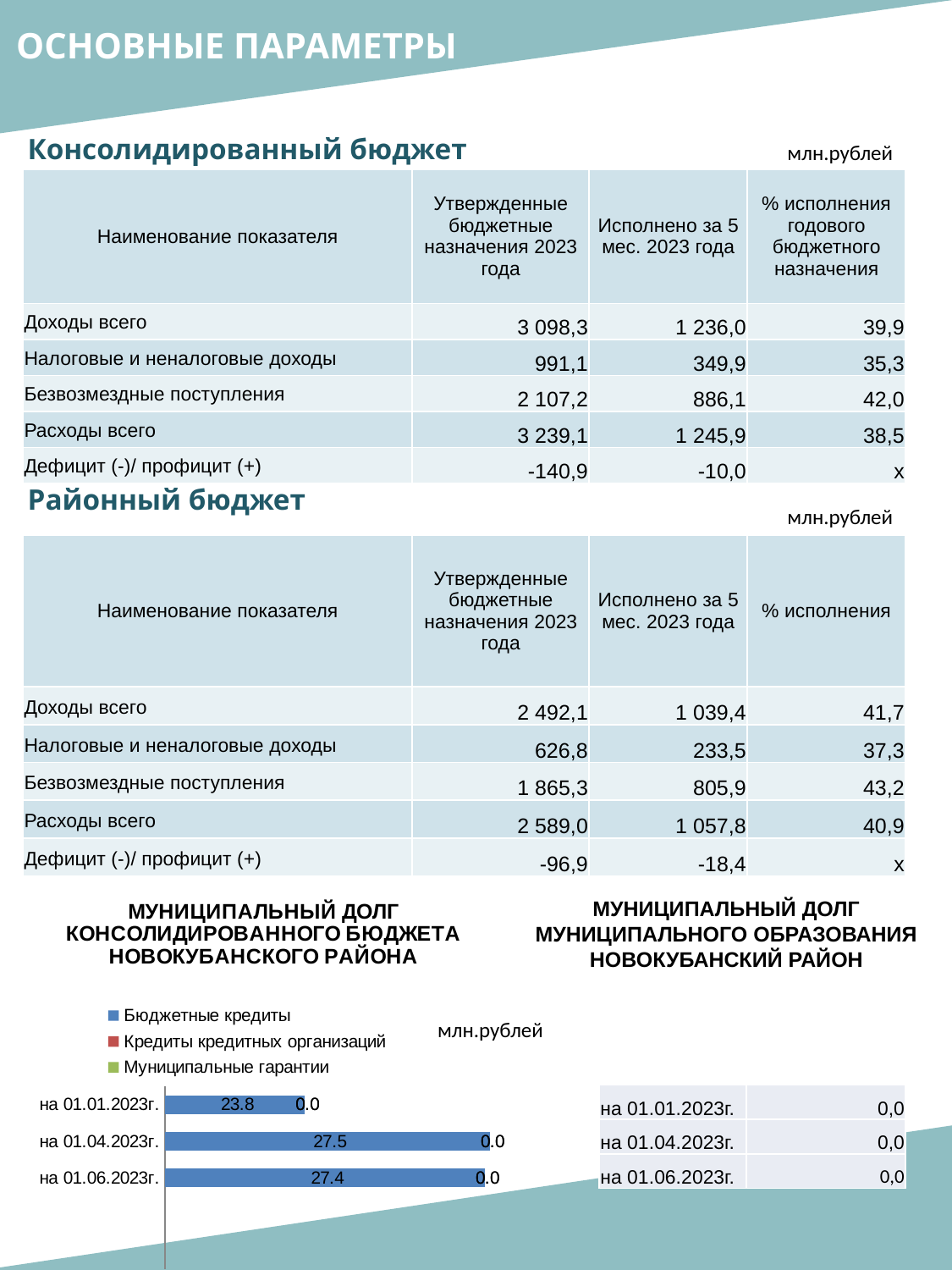
In the bar chart, what is the value of "Бюджетные кредиты" for "на 01.04.2023г."? 27.5 What kind of chart is shown under the title "МУНИЦИПАЛЬНЫЙ ДОЛГ КОНСОЛИДИРОВАННОГО БЮДЖЕТА НОВОКУБАНСКОГО РАЙОНА"? bar chart In the bar chart, what is the value of "Бюджетные кредиты" for "на 01.01.2023г."? 23.8 In the bar chart, which date has the lowest value for "Бюджетные кредиты"? на 01.01.2023г. In the bar chart, which is larger: the "Бюджетные кредиты" value for "на 01.01.2023г." or for "на 01.06.2023г."? на 01.06.2023г. In the bar chart, what is the value of "Бюджетные кредиты" for "на 01.06.2023г."? 27.4 What unit is indicated next to the bar chart? млн.рублей In the bar chart, what is the difference between the "Бюджетные кредиты" values for "на 01.04.2023г." and "на 01.01.2023г."? 3.7 How many date categories are shown in the bar chart? 3 How many series does the legend of the bar chart list? 3 In the bar chart, what is the value shown for "Кредиты кредитных организаций" for "на 01.06.2023г."? 0.0 Which series in the bar chart is shown in blue? Бюджетные кредиты